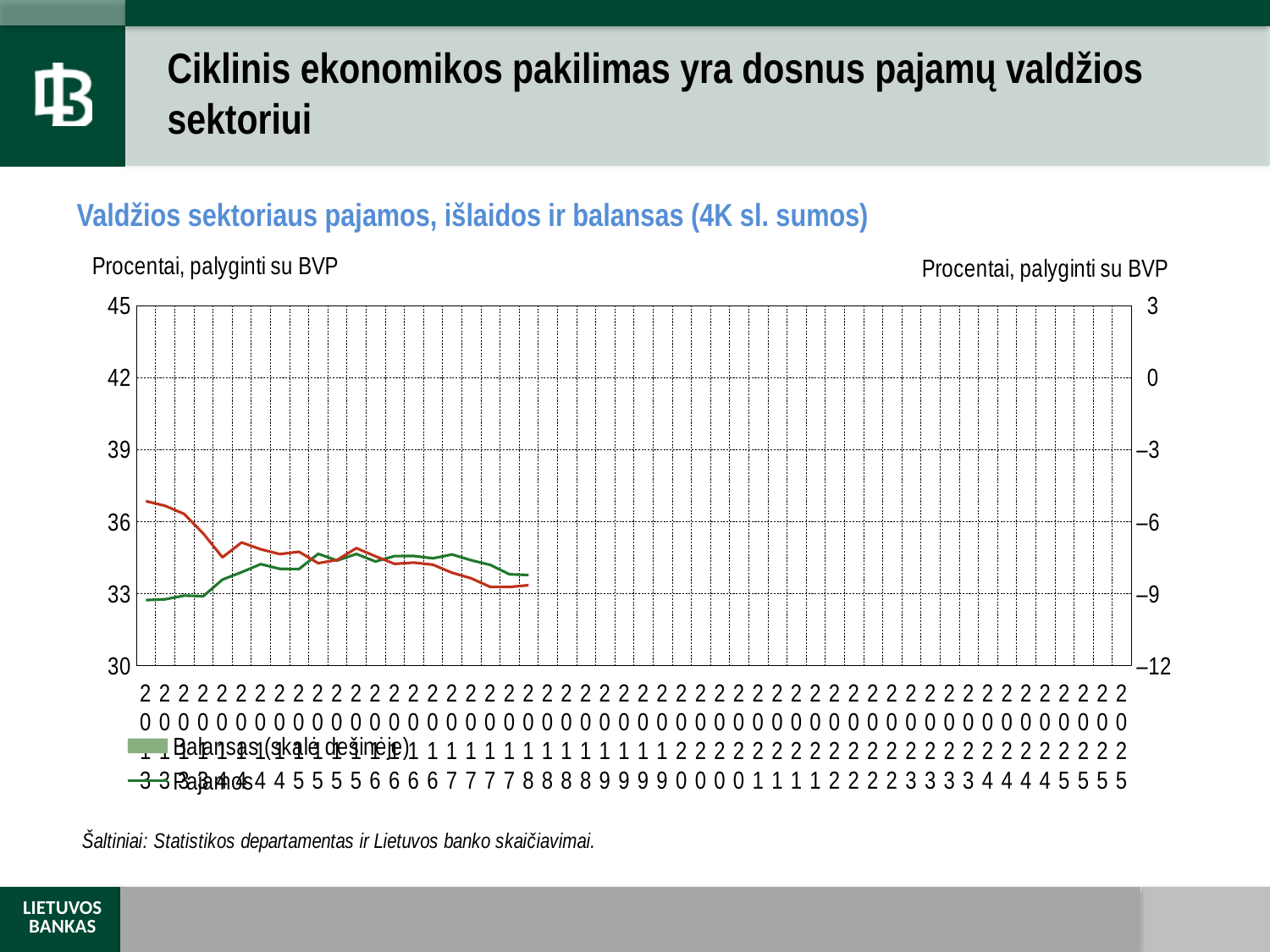
Does the red line overall rise or fall from left to right? fall Is the highest point of the green line greater or less than 36 on the left axis? less Is the value of the red line at the right end of the chart greater or less than 36 on the left axis? less What kind of chart is shown on the slide? line chart Does the green line overall rise or fall from left to right? rise What is the title of the chart? Valdžios sektoriaus pajamos, išlaidos ir balansas (4K sl. sumos) Is the value of the red line at the right end of the chart greater or less than 33 on the left axis? greater At the left end of the chart, which line is higher, the red line or the green line? red line What label is shown above the left vertical axis of the chart? Procentai, palyginti su BVP